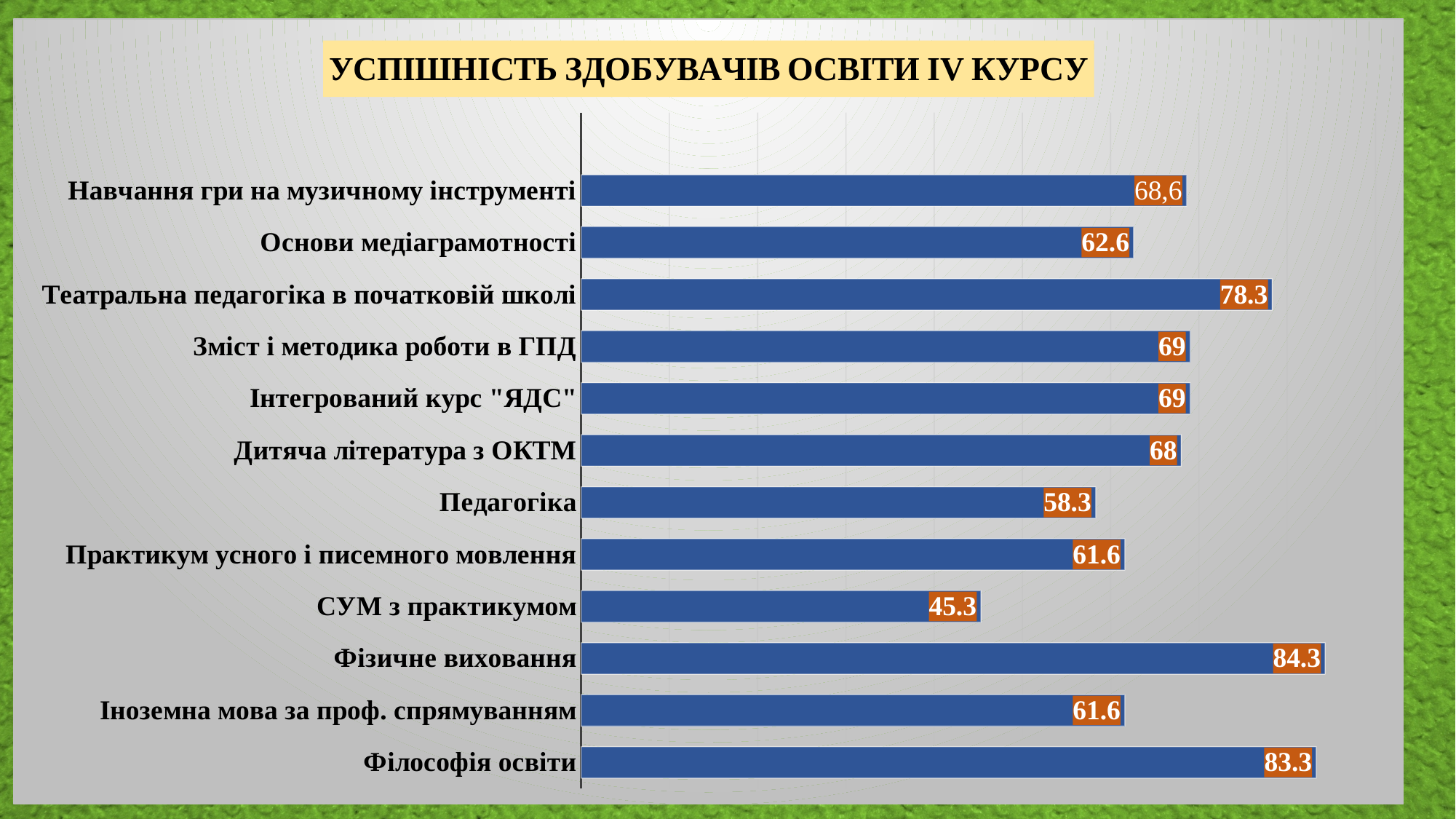
What is the title of the slide? УСПІШНІСТЬ ЗДОБУВАЧІВ ОСВІТИ IV КУРСУ What kind of chart is shown on the slide? Bar chart Which category has the highest value? Фізичне виховання What is the value for Театральна педагогіка в початковій школі? 78.3 What is the value for Фізичне виховання? 84.3 What is the value for Педагогіка? 58.3 What is the difference between the values for Театральна педагогіка в початковій школі and Педагогіка? 20 How many categories are shown in the chart? 12 Which is larger, the value for Основи медіаграмотності or the value for Театральна педагогіка в початковій школі? Театральна педагогіка в початковій школі What is the value for Навчання гри на музичному інструменті? 68,6 What is the difference between the values for Фізичне виховання and СУМ з практикумом? 39 Which category has the lowest value? СУМ з практикумом